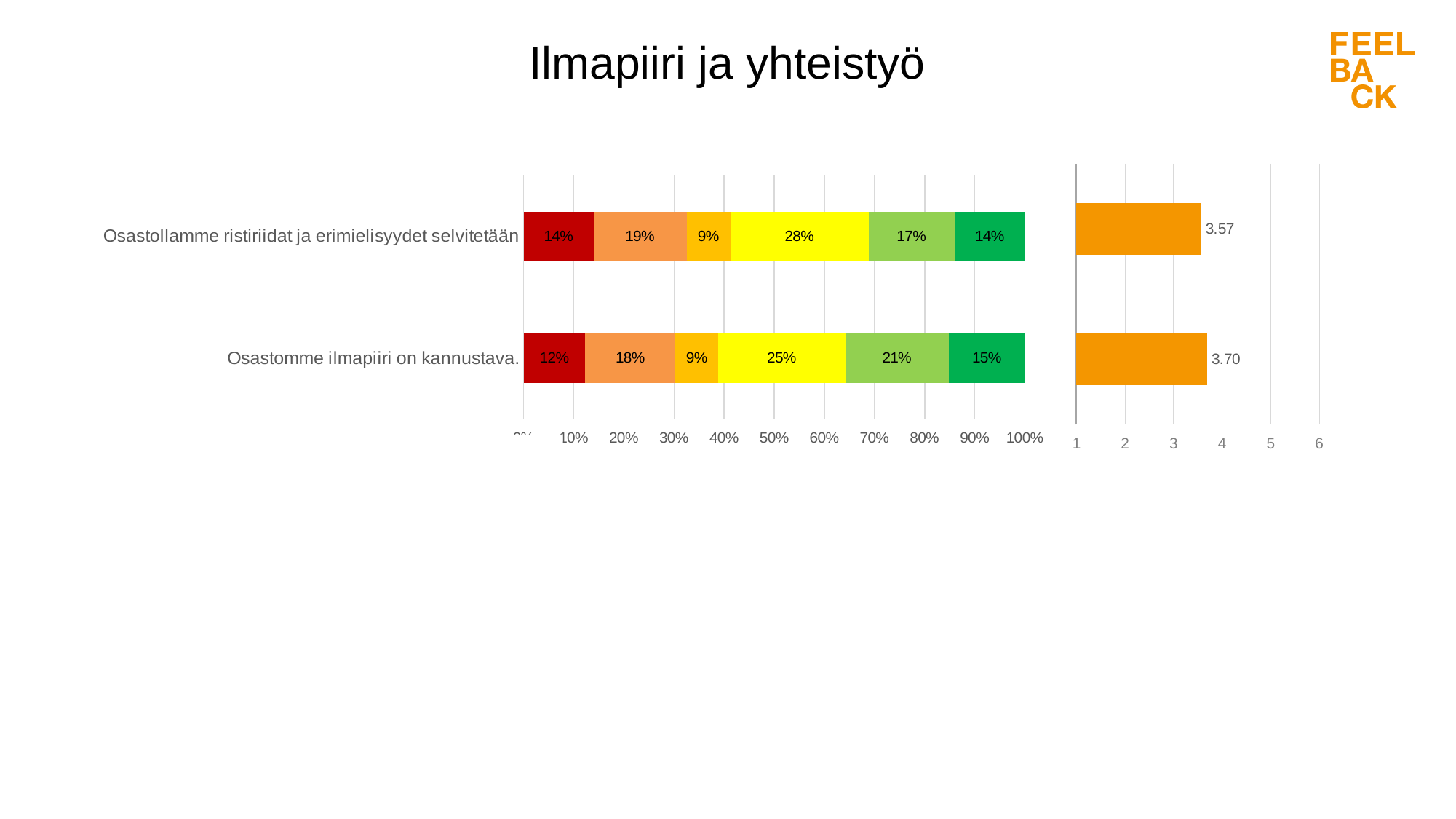
What kind of chart is the chart on the right of the slide? Bar chart In the bar chart on the right, what is the value for "Osastollamme ristiriidat ja erimielisyydet selvitetään"? 3.57 In the bar chart on the right, what is the value for "Osastomme ilmapiiri on kannustava."? 3.70 In the stacked bar chart on the left, which category has the larger yellow segment, "Osastollamme ristiriidat ja erimielisyydet selvitetään" or "Osastomme ilmapiiri on kannustava."? Osastollamme ristiriidat ja erimielisyydet selvitetään In the stacked bar chart on the left, what is the value of the light green segment for "Osastollamme ristiriidat ja erimielisyydet selvitetään"? 17% In the bar chart on the right, what is the difference between the values for "Osastomme ilmapiiri on kannustava." and "Osastollamme ristiriidat ja erimielisyydet selvitetään"? 0.13 In the stacked bar chart on the left, what is the value of the yellow segment for "Osastomme ilmapiiri on kannustava."? 25% In the stacked bar chart on the left, what is the value of the dark red (first) segment for "Osastollamme ristiriidat ja erimielisyydet selvitetään"? 14% In the bar chart on the right, is the value for "Osastomme ilmapiiri on kannustava." greater or less than 4? less How many categories are shown in the stacked bar chart on the left? 2 In the bar chart on the right, which category has the highest value? Osastomme ilmapiiri on kannustava. In the stacked bar chart on the left, what is the value of the dark green (last) segment for "Osastomme ilmapiiri on kannustava."? 15%